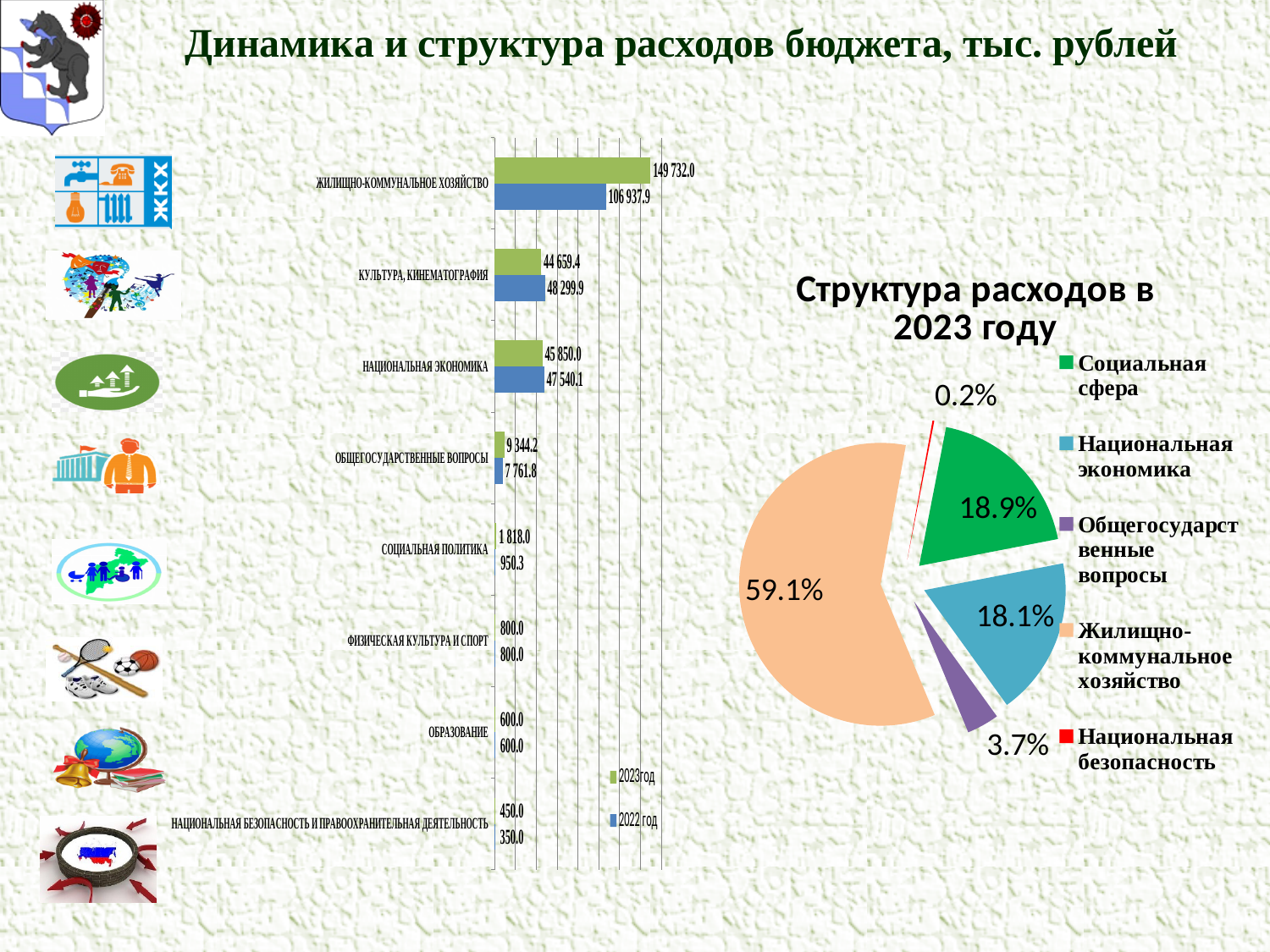
On the bar chart on the left, which is larger for Национальная экономика: the 2023 год value or the 2022 год value? 2022 год On the pie chart 'Структура расходов в 2023 году', what share does Жилищно-коммунальное хозяйство have? 59.1% On the bar chart on the left, what is the 2022 год value for Культура, кинематография? 48 299.9 How many series does the legend of the bar chart on the left list? 2 On the bar chart on the left, what is the 2023 год value for Жилищно-коммунальное хозяйство? 149 732.0 What type of chart is the chart on the right titled 'Структура расходов в 2023 году'? pie chart How many categories are shown on the bar chart on the left? 8 On the bar chart on the left, what is the 2023 год value for Общегосударственные вопросы? 9 344.2 On the pie chart 'Структура расходов в 2023 году', which category has the smallest share? Национальная безопасность On the bar chart on the left, which category has the lowest 2022 год value? Национальная безопасность и правоохранительная деятельность On the bar chart on the left, what is the difference between the 2023 год and 2022 год values for Социальная политика? 867.7 On the bar chart on the left, which category has the highest 2023 год value? Жилищно-коммунальное хозяйство